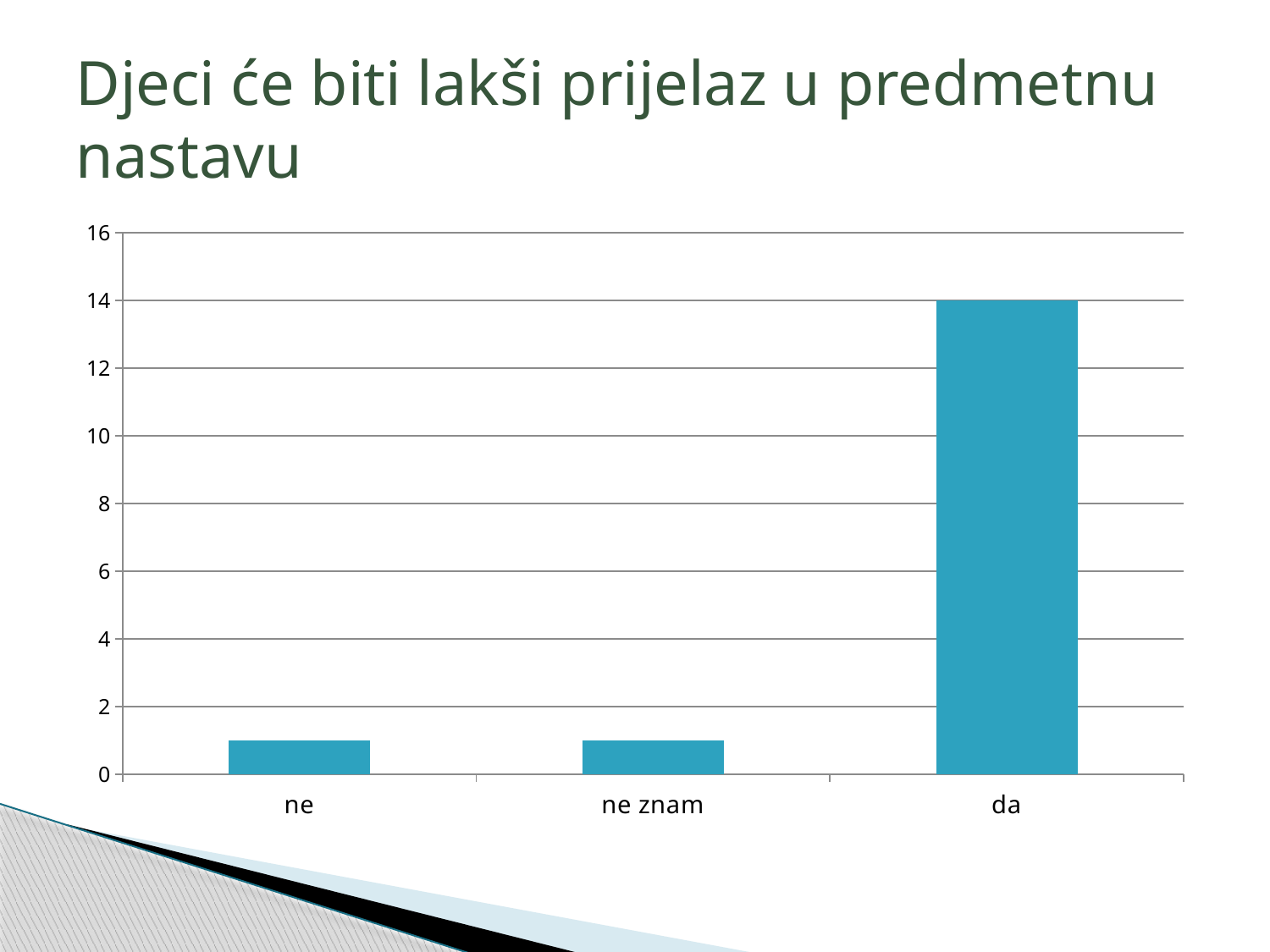
Which is larger, the value for "da" or the value for "ne"? da What is the highest value shown on the vertical axis? 16 What is the value for "da"? 14 How many categories are shown on the x axis? 3 Which category has the highest value? da Is the value for "ne znam" greater or less than 2? less Is the value for "ne" greater or less than 2? less Which is larger, the value for "ne znam" or the value for "da"? da What is the title of the slide? Djeci će biti lakši prijelaz u predmetnu nastavu What kind of chart is shown on the slide? bar chart Is the value for "da" greater or less than 10? greater